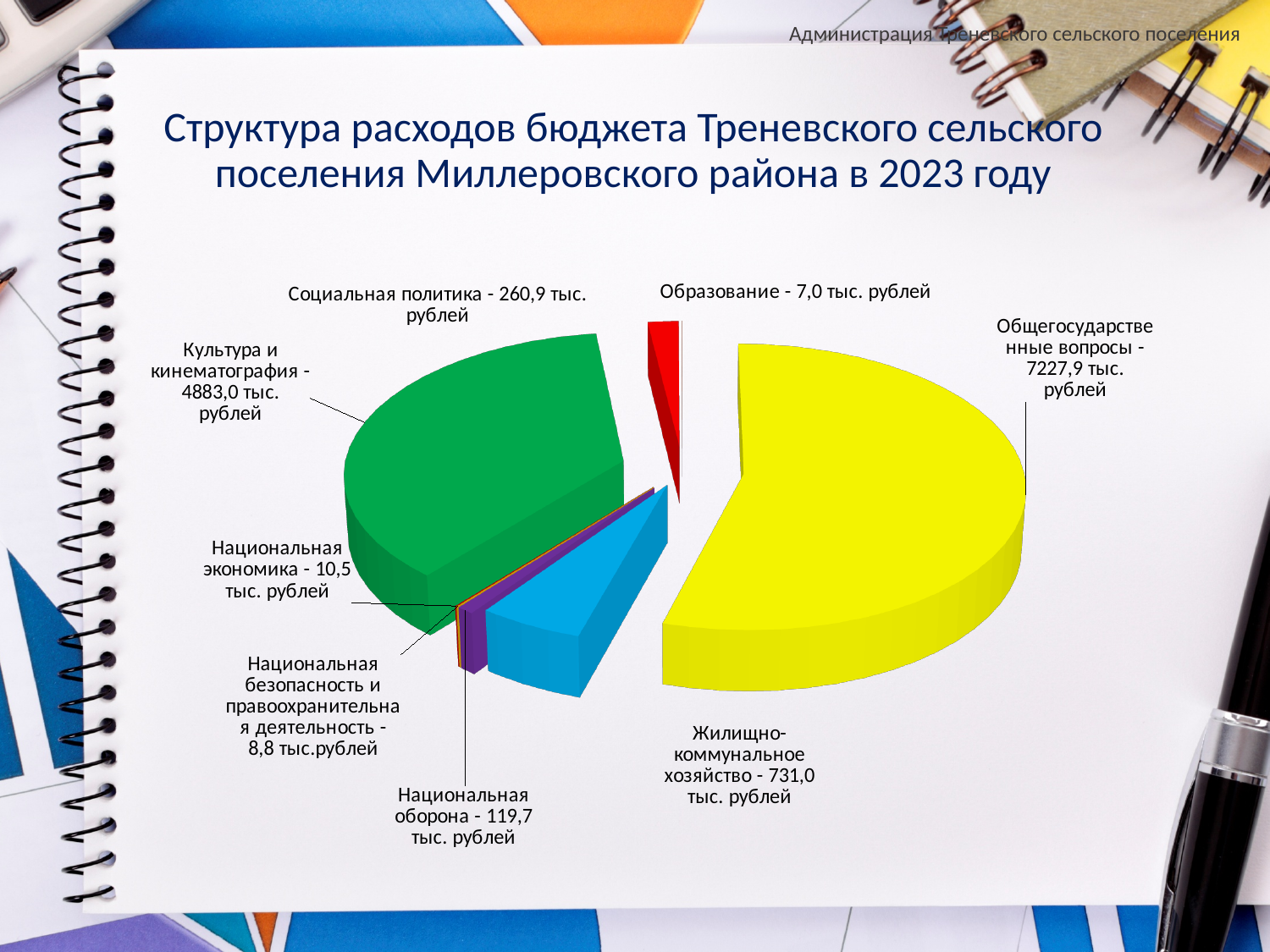
Which category has the smallest expenditure? Образование Which is larger: Социальная политика or Национальная оборона? Социальная политика What is the value for Образование? 7,0 тыс. рублей What is the value for Жилищно-коммунальное хозяйство? 731,0 тыс. рублей What type of chart is shown on the slide? Pie chart What is the value for Общегосударственные вопросы? 7227,9 тыс. рублей What is the value for Национальная оборона? 119,7 тыс. рублей How many categories are shown in the pie chart? 8 What is the title of the chart on the slide? Структура расходов бюджета Треневского сельского поселения Миллеровского района в 2023 году What is the difference between Общегосударственные вопросы and Культура и кинематография? 2344,9 тыс. рублей What is the value for Культура и кинематография? 4883,0 тыс. рублей Which category has the largest expenditure? Общегосударственные вопросы